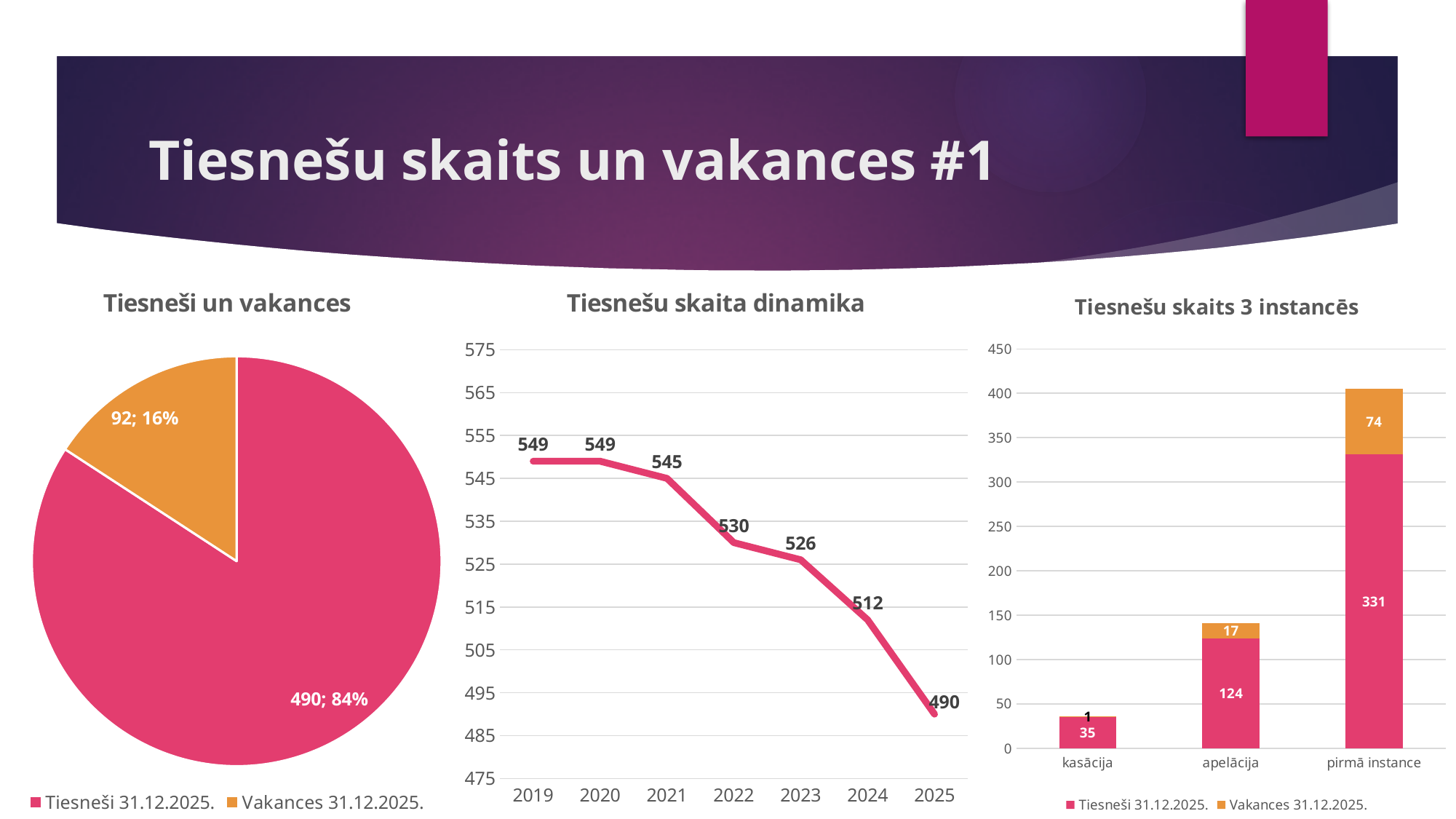
In the 'Tiesnešu skaita dinamika' chart, what is the difference between the 2019 value and the 2025 value? 59 In the 'Tiesneši un vakances' pie chart, what value and share are shown for Vakances 31.12.2025.? 92; 16% In the 'Tiesneši un vakances' pie chart, what share of the pie does Tiesneši 31.12.2025. take? 84% In the 'Tiesnešu skaits 3 instancēs' chart, what is the total of the stacked bar for pirmā instance? 405 How many series does the legend of the 'Tiesnešu skaits 3 instancēs' chart list? 2 What kind of chart is 'Tiesneši un vakances'? pie chart In the 'Tiesnešu skaita dinamika' chart, do the values rise or fall from 2019 to 2025? fall How many years are plotted in the 'Tiesnešu skaita dinamika' chart? 7 In the 'Tiesnešu skaita dinamika' chart, what is the value for 2022? 530 In the 'Tiesnešu skaits 3 instancēs' chart, what is the Tiesneši 31.12.2025. value for apelācija? 124 In the 'Tiesnešu skaita dinamika' chart, which year has the lowest value? 2025 In the 'Tiesnešu skaits 3 instancēs' chart, which category has the highest Vakances 31.12.2025. value? pirmā instance